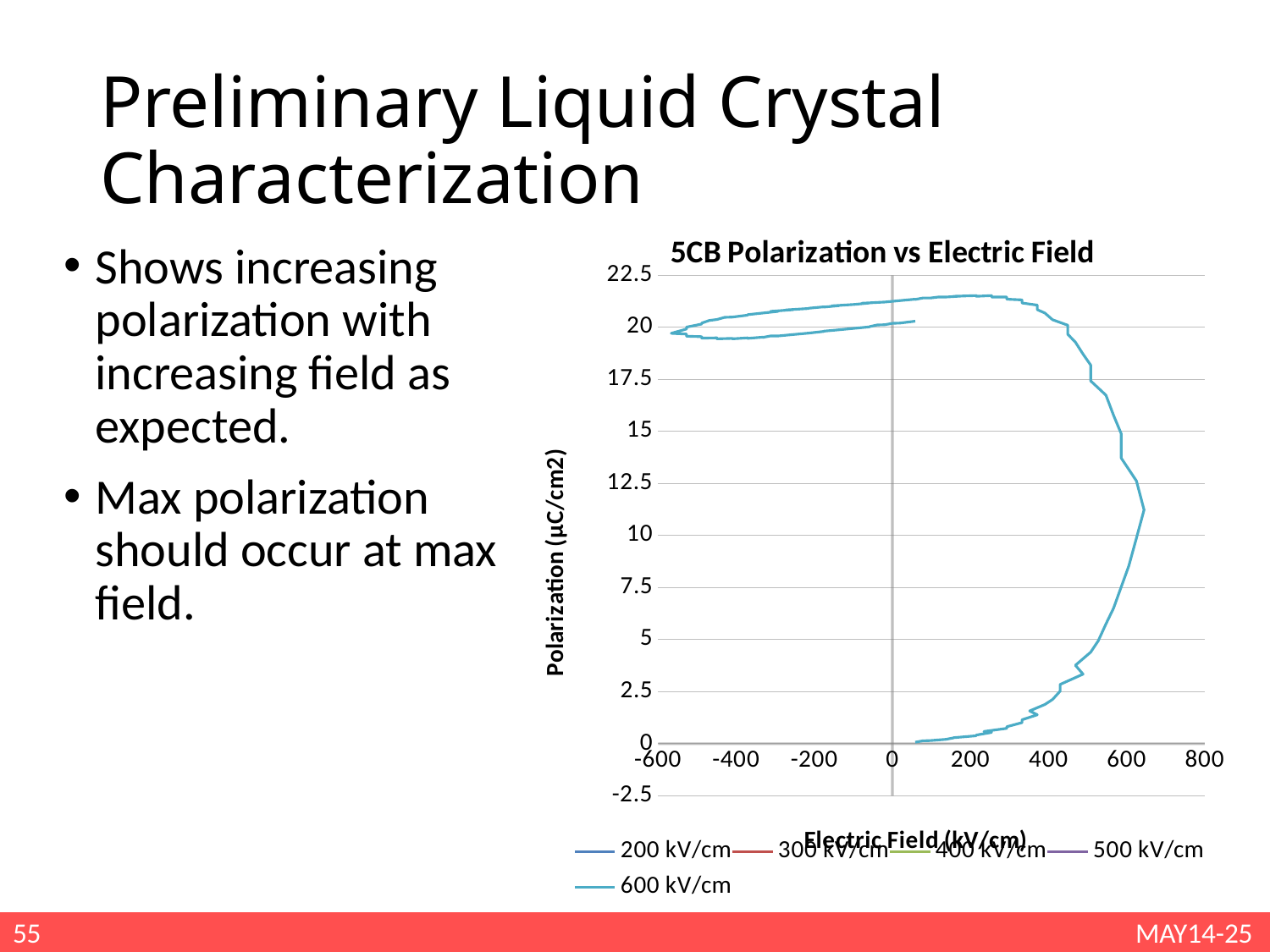
Is the highest polarization value reached by the plotted curve greater or less than 20? greater What is the label of the vertical axis of the chart? Polarization (µC/cm2) Is the highest polarization value reached by the plotted curve greater or less than 22.5? less Is the largest electric field value reached by the plotted curve greater or less than 600? greater How many series does the chart legend list? 5 What kind of chart is shown on the slide? line chart What is the title of the chart? 5CB Polarization vs Electric Field